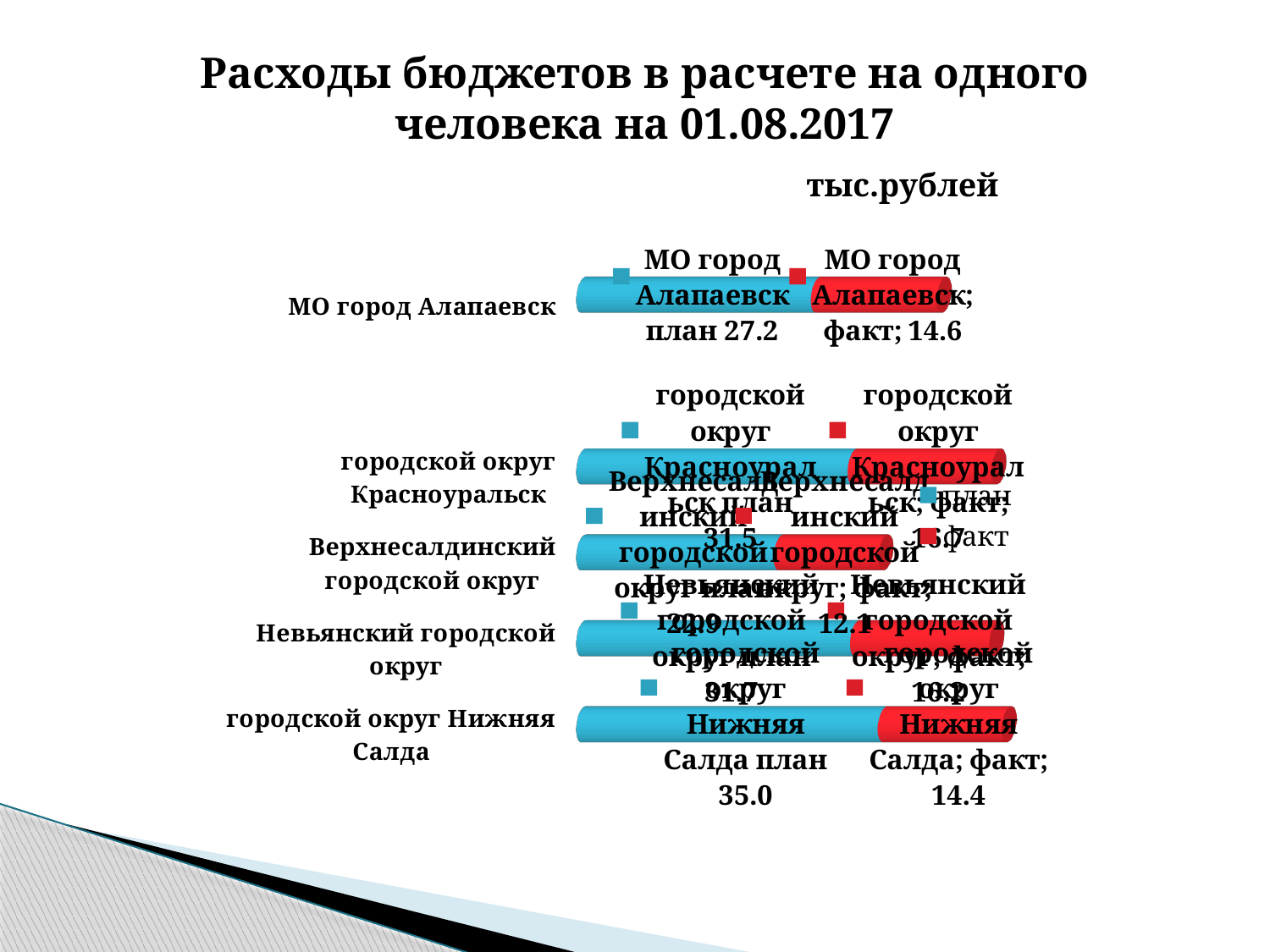
What is the план value for МО город Алапаевск? 27.2 Which is larger, the план value for городской округ Нижняя Салда or the план value for МО город Алапаевск? городской округ Нижняя Салда What is the факт value for МО город Алапаевск? 14.6 What is the план value for городской округ Нижняя Салда? 35.0 What is the difference between the план and факт values for МО город Алапаевск? 12.6 What is the факт value for городской округ Нижняя Салда? 14.4 What kind of chart is shown on the slide? bar chart What is the total of the stacked bar for МО город Алапаевск? 41.8 What is the difference between the план and факт values for городской округ Нижняя Салда? 20.6 What unit is stated for the values on the chart? тыс.рублей For МО город Алапаевск, which is larger, план or факт? план How many categories are shown on the chart? 5